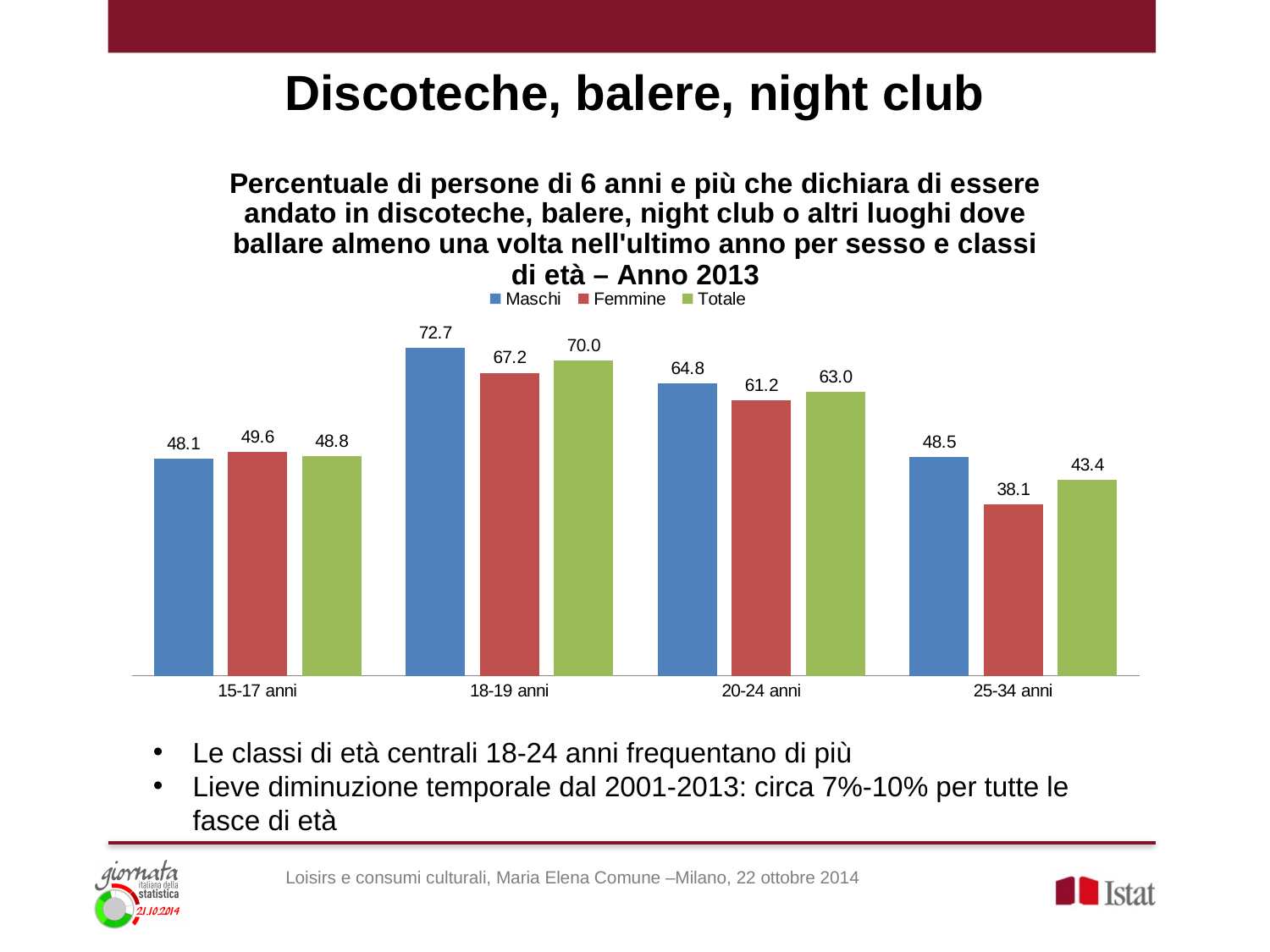
How many age groups are shown on the x axis? 4 Which is larger in the 15-17 anni age group, the Maschi value or the Femmine value? Femmine What is the value for Femmine in the 25-34 anni age group? 38.1 Which age group has the lowest value for Femmine? 25-34 anni What kind of chart is shown on the slide? Bar chart How many series does the legend list? 3 What is the value for Totale in the 20-24 anni age group? 63.0 What is the value for Maschi in the 18-19 anni age group? 72.7 What is the difference between the Maschi and Femmine values in the 25-34 anni age group? 10.4 Which series is shown in green in the legend? Totale Which age group has the highest value for Totale? 18-19 anni Does the Totale value rise or fall from 20-24 anni to 25-34 anni? Fall